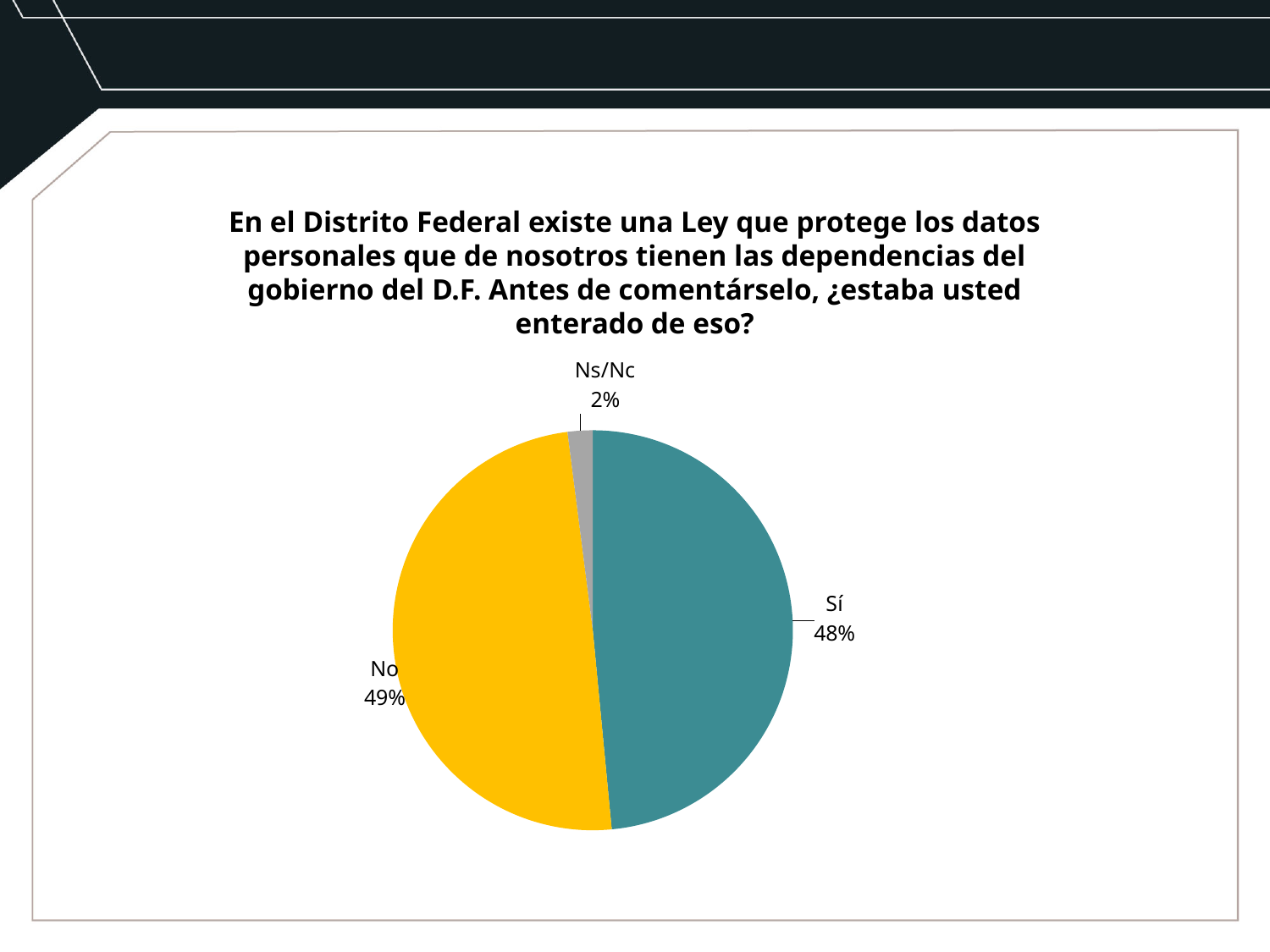
Which category has the smallest slice of the pie? Ns/Nc What percentage of respondents answered "Sí"? 48% What kind of chart is shown on the slide? Pie chart What share of the pie does the "Sí" slice represent? 48% How many slices does the pie chart have? 3 What percentage is shown for the "Ns/Nc" slice? 2% Which is larger, the share for "Sí" or the share for "No"? No What percentage of respondents answered "No"? 49% What is the difference in percentage points between "Sí" and "Ns/Nc"? 46 percentage points What is the difference in percentage points between "No" and "Sí"? 1 percentage point What colour is the "No" slice of the pie? Yellow Which category has the largest slice of the pie? No